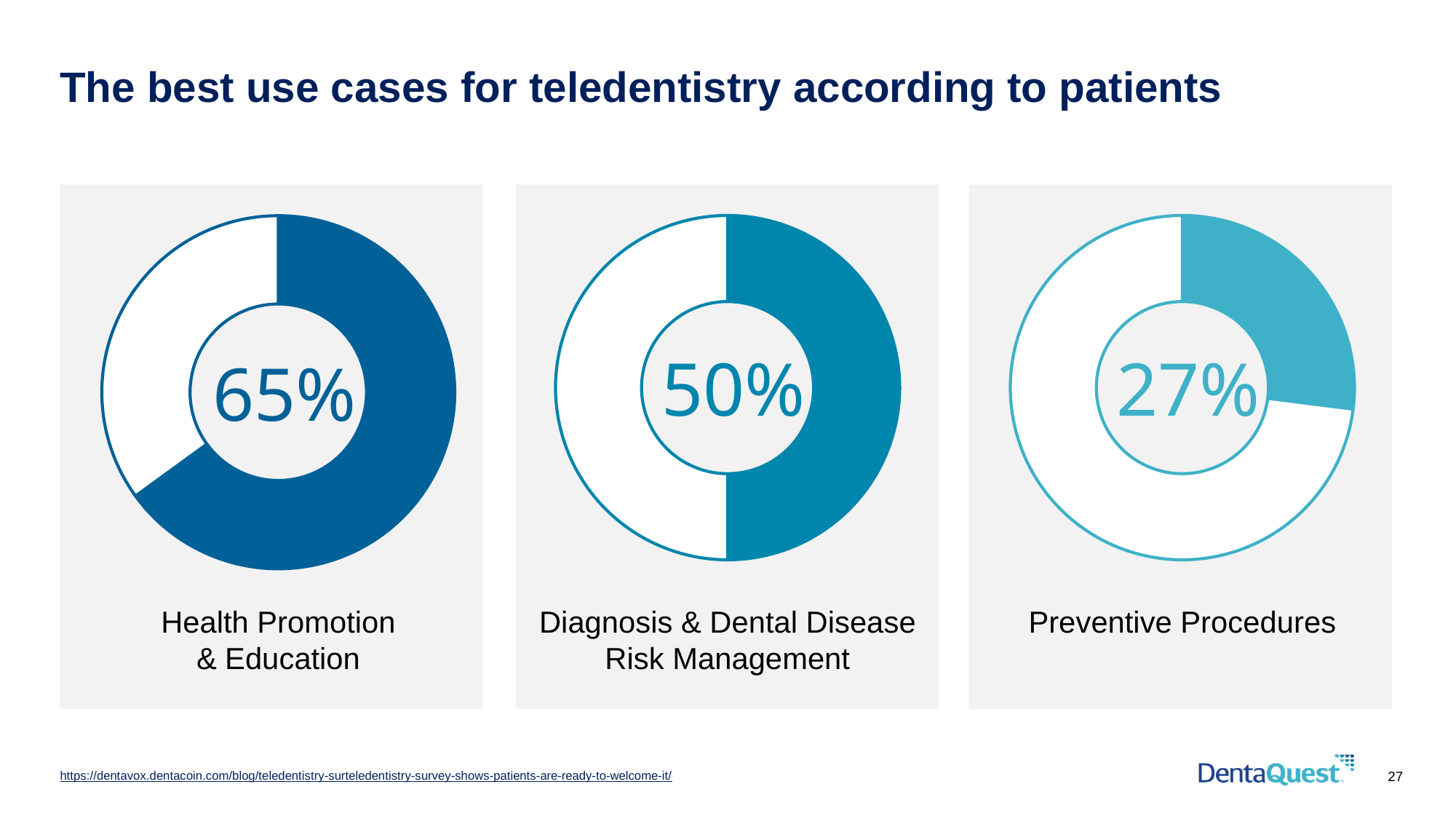
What kind of chart is used to show each percentage? Donut chart Which use case is shown in the middle chart? Diagnosis & Dental Disease Risk Management What percentage is shown for Preventive Procedures? 27% What is the title of the slide? The best use cases for teledentistry according to patients Which use case has the highest percentage? Health Promotion & Education Which use case has the lowest percentage? Preventive Procedures What is the difference in percentage points between Health Promotion & Education and Preventive Procedures? 38 How many use cases are shown on the slide? 3 What percentage is shown for Diagnosis & Dental Disease Risk Management? 50% Which is larger: the value for Diagnosis & Dental Disease Risk Management or the value for Preventive Procedures? Diagnosis & Dental Disease Risk Management What percentage is shown for Health Promotion & Education? 65% What is the difference in percentage points between Health Promotion & Education and Diagnosis & Dental Disease Risk Management? 15